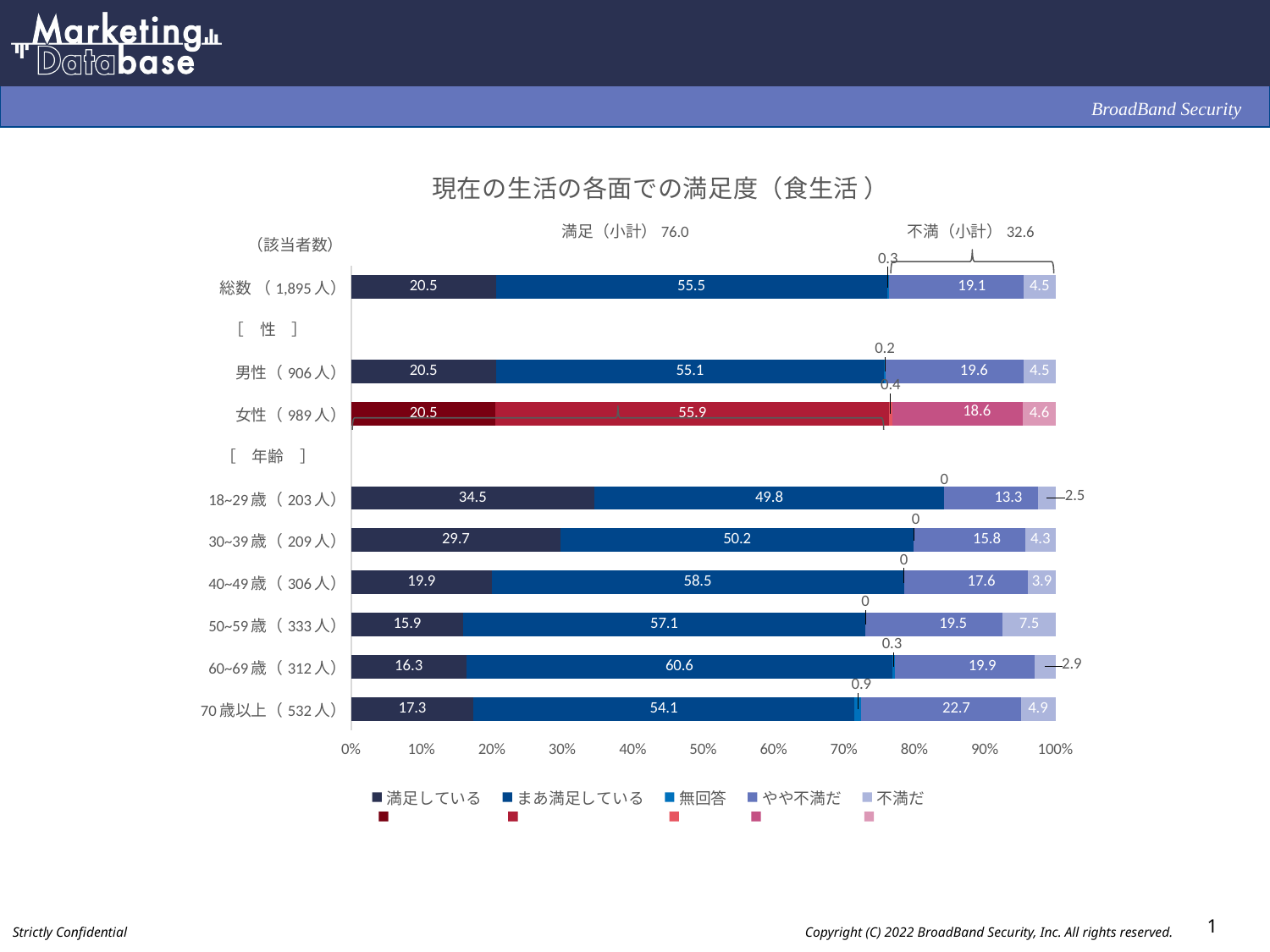
What is the difference between the まあ満足している values for 60~69歳 and 70歳以上? 6.5 What is the total of the stacked bar for 総数 (1,895人)? 99.9 What is the value of 満足している for 総数 (1,895人)? 20.5 Which category has the highest value for 満足している? 18~29歳 (203人) Which category has the lowest value for 不満だ? 18~29歳 (203人) What is the 満足（小計） value shown above the chart? 76.0 How many labelled series does the legend list? 5 How many categories (bars) are plotted in the chart? 9 What is the value of まあ満足している for 40~49歳 (306人)? 58.5 Which is larger, the 不満だ value for 50~59歳 or for 30~39歳? 50~59歳 What is the value of やや不満だ for 70歳以上 (532人)? 22.7 What kind of chart is shown on the slide? Stacked bar chart